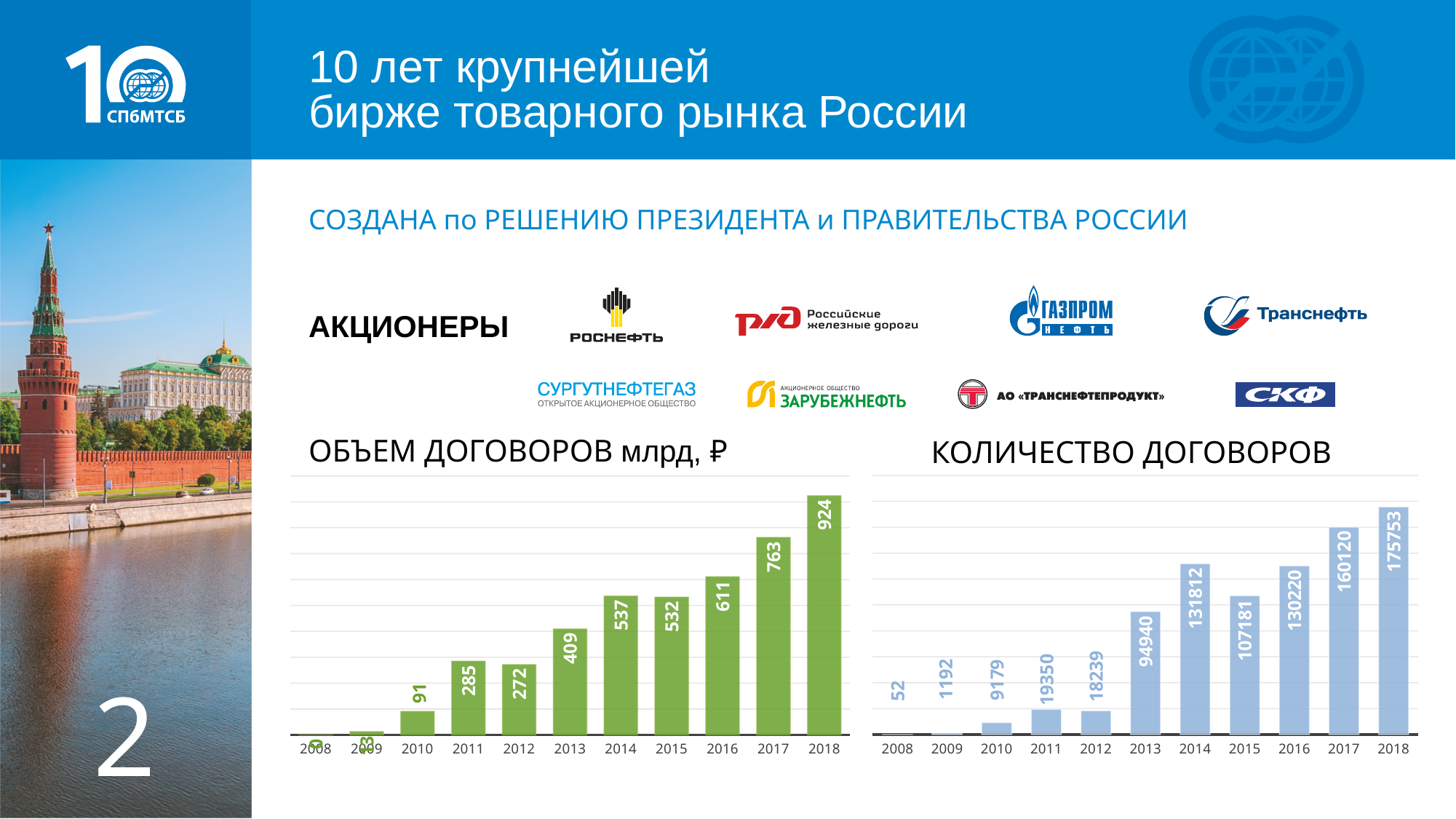
In the chart titled 'ОБЪЕМ ДОГОВОРОВ млрд, ₽', what is the value for 2013? 409 In the chart titled 'КОЛИЧЕСТВО ДОГОВОРОВ', what is the difference between the values for 2018 and 2017? 15633 In the chart titled 'ОБЪЕМ ДОГОВОРОВ млрд, ₽', what is the difference between the values for 2018 and 2017? 161 In the chart titled 'ОБЪЕМ ДОГОВОРОВ млрд, ₽', which year has the highest value? 2018 In the chart titled 'КОЛИЧЕСТВО ДОГОВОРОВ', what is the value for 2008? 52 In the chart titled 'КОЛИЧЕСТВО ДОГОВОРОВ', what is the value for 2014? 131812 In the chart titled 'ОБЪЕМ ДОГОВОРОВ млрд, ₽', which is larger, the value for 2011 or the value for 2012? 2011 How many years are shown on the x axis of the chart titled 'КОЛИЧЕСТВО ДОГОВОРОВ'? 11 What type of chart is the chart titled 'ОБЪЕМ ДОГОВОРОВ млрд, ₽'? Bar chart In the chart titled 'КОЛИЧЕСТВО ДОГОВОРОВ', which year has the lowest value? 2008 In the chart titled 'ОБЪЕМ ДОГОВОРОВ млрд, ₽', what is the value for 2018? 924 In the chart titled 'КОЛИЧЕСТВО ДОГОВОРОВ', which is larger, the value for 2014 or the value for 2015? 2014